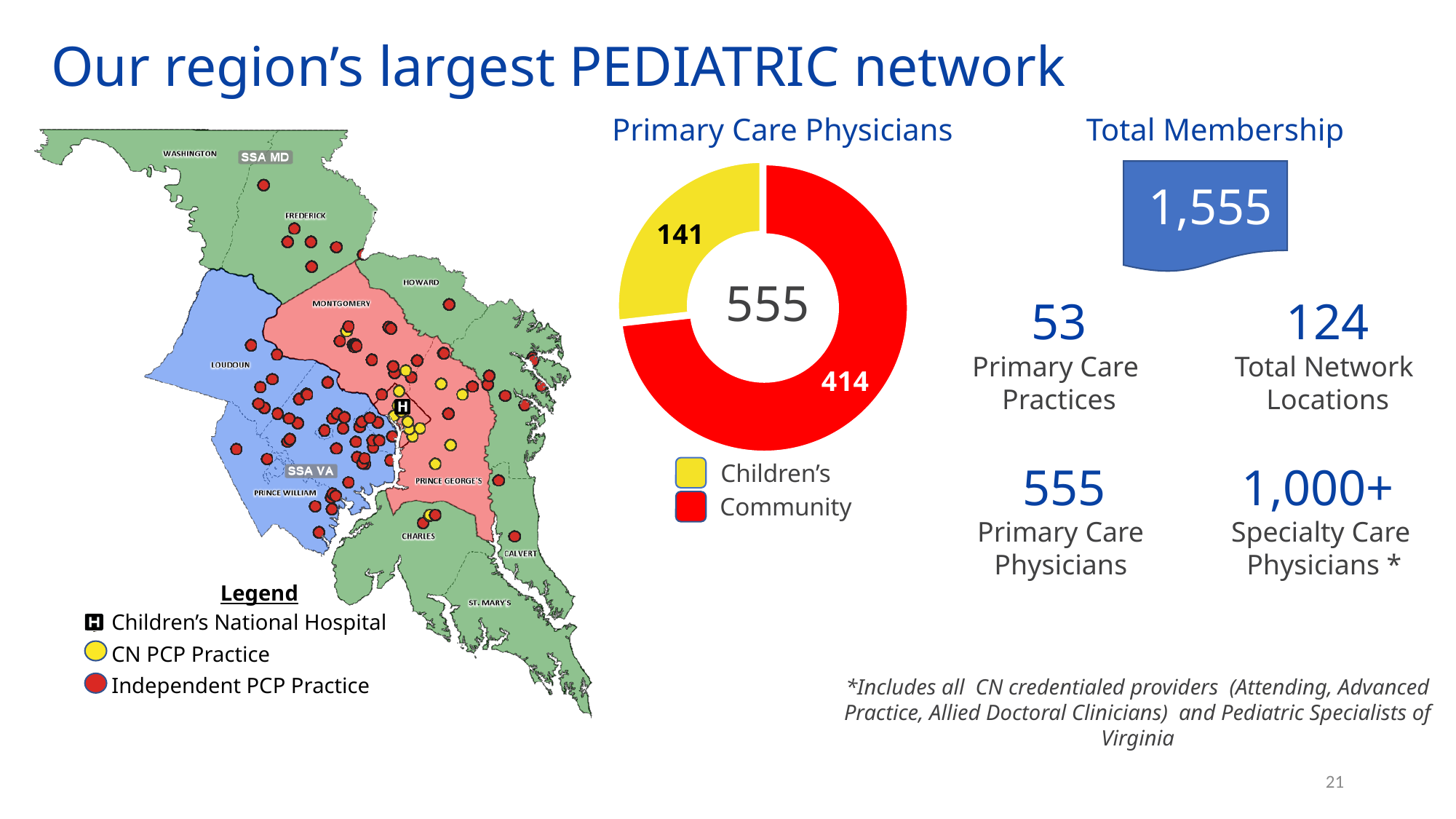
In the Primary Care Physicians chart, what is the difference between the Community and Children's values? 273 In the Primary Care Physicians chart, what colour represents Community? Red In the Primary Care Physicians chart, what colour represents Children's? Yellow In the Primary Care Physicians chart, is the value for Children's larger or smaller than the value for Community? Smaller In the Primary Care Physicians chart, what is the value for Community? 414 What kind of chart is shown under the title "Primary Care Physicians"? Donut (pie) chart What total is shown in the center of the Primary Care Physicians donut chart? 555 In the Primary Care Physicians chart, which category has the largest value? Community In the Primary Care Physicians chart, what is the value for Children's? 141 In the Primary Care Physicians chart, what share of the total 555 does the Children's slice (141) represent? 25.4% In the Primary Care Physicians chart, which category has the smallest value? Children's How many categories does the legend of the Primary Care Physicians chart list? 2